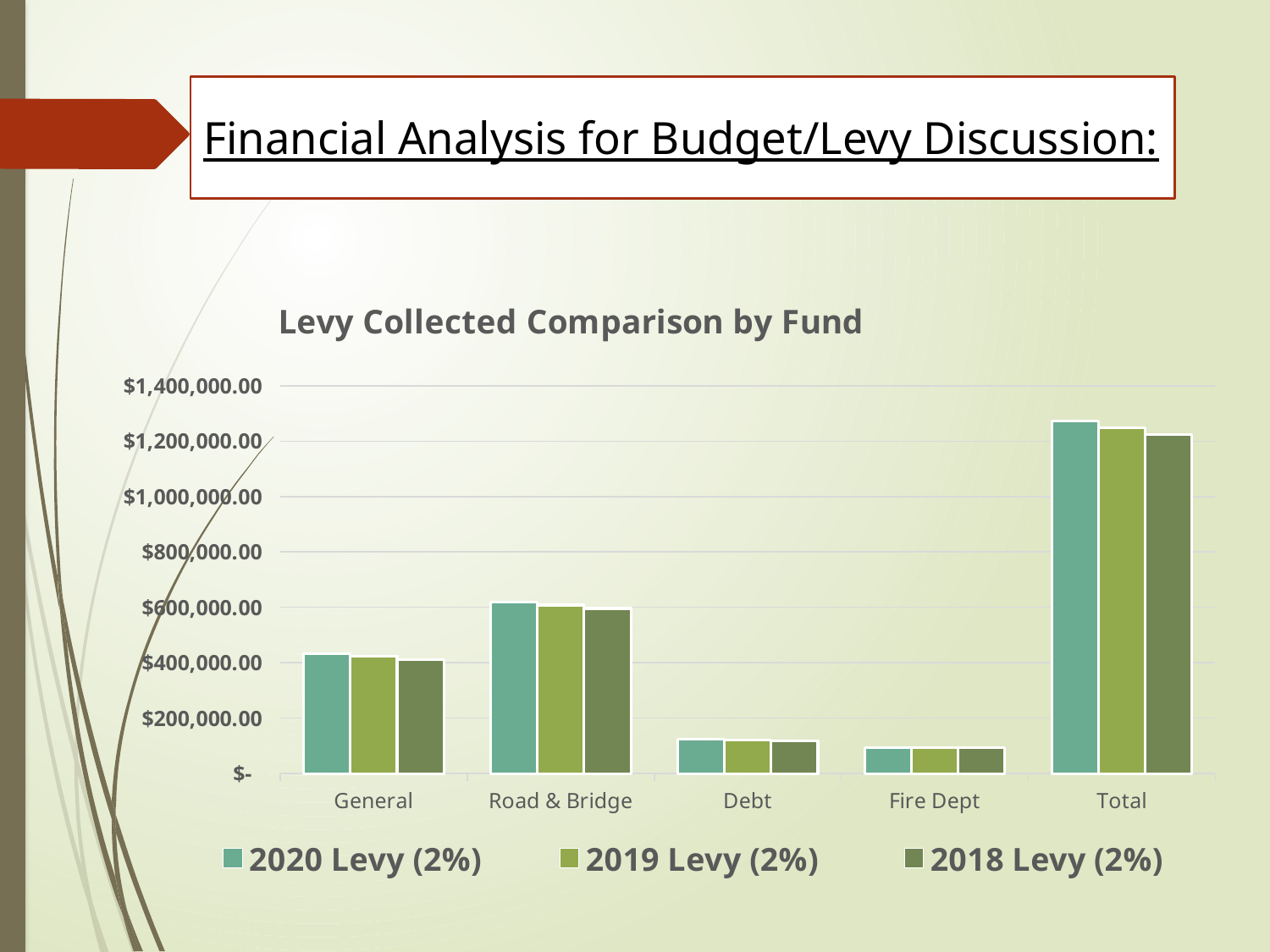
Which category has the lowest bars? Fire Dept What is the title of the chart? Levy Collected Comparison by Fund How many fund categories are shown on the x axis? 5 Is the 2019 Levy (2%) value for Debt greater or less than $200,000.00? less Which is larger for the 2020 Levy (2%): Debt or Fire Dept? Debt Which category has the tallest bars? Total How many series does the legend list? 3 Is the 2020 Levy (2%) value for Total greater or less than $1,200,000.00? greater Excluding Total, which fund has the highest levy collected? Road & Bridge Is the 2020 Levy (2%) value for General greater or less than $400,000.00? greater Which legend entry is shown in the lightest teal colour? 2020 Levy (2%) What kind of chart is shown on the slide? bar chart